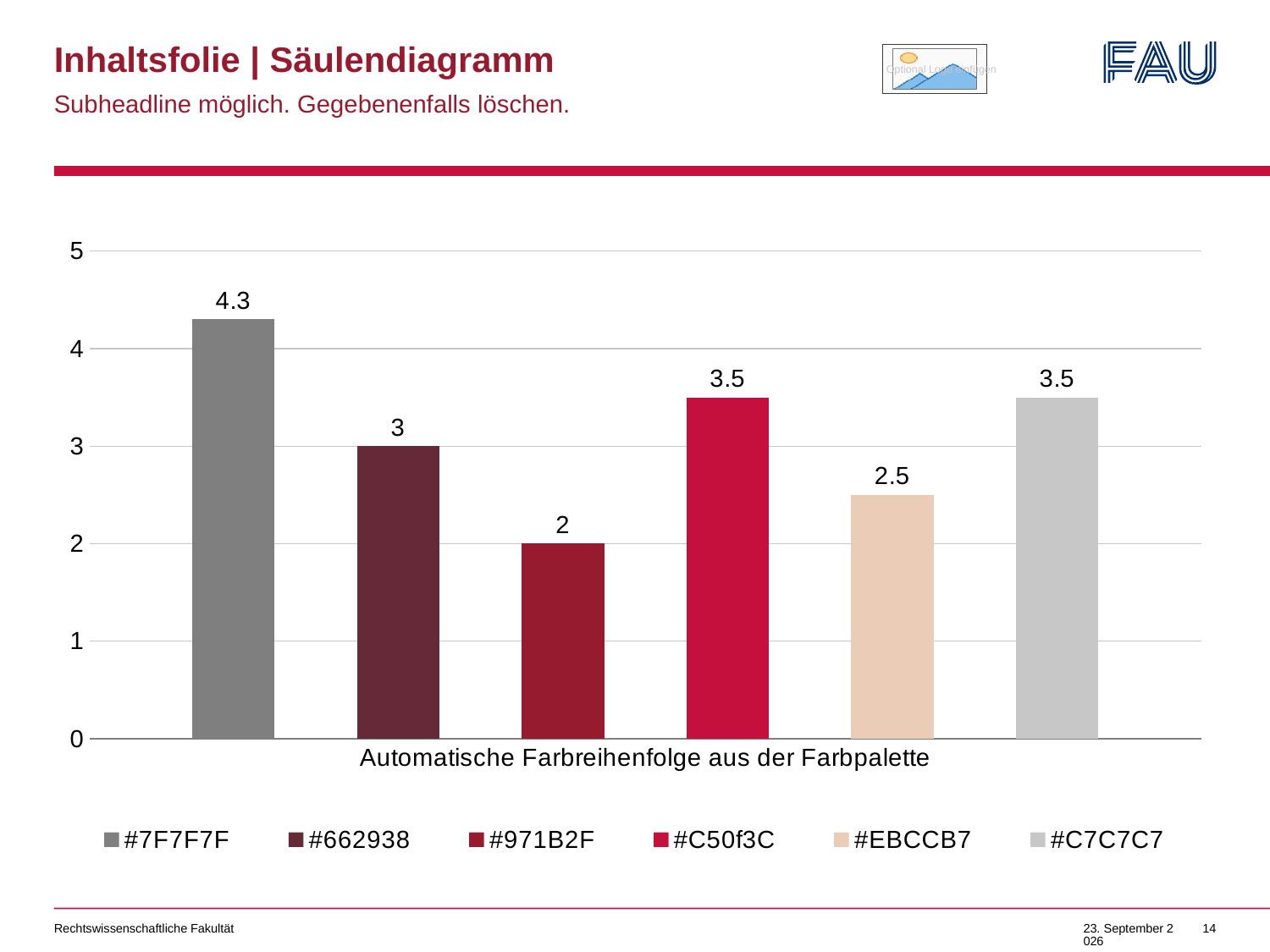
What is the difference between the values for #7F7F7F and #971B2F? 2.3 What kind of chart is shown on the slide? bar chart Which is larger, the value for #662938 or the value for #EBCCB7? #662938 What is the category label shown below the bars? Automatische Farbreihenfolge aus der Farbpalette What is the value for the #EBCCB7 series? 2.5 What is the value for the #7F7F7F series? 4.3 What is the value for the #662938 series? 3 Which series has the highest value? #7F7F7F How many series does the legend list? 6 How many bars are plotted in the chart? 6 Is the value for #C50f3C greater or less than 3? greater Which series has the lowest value? #971B2F